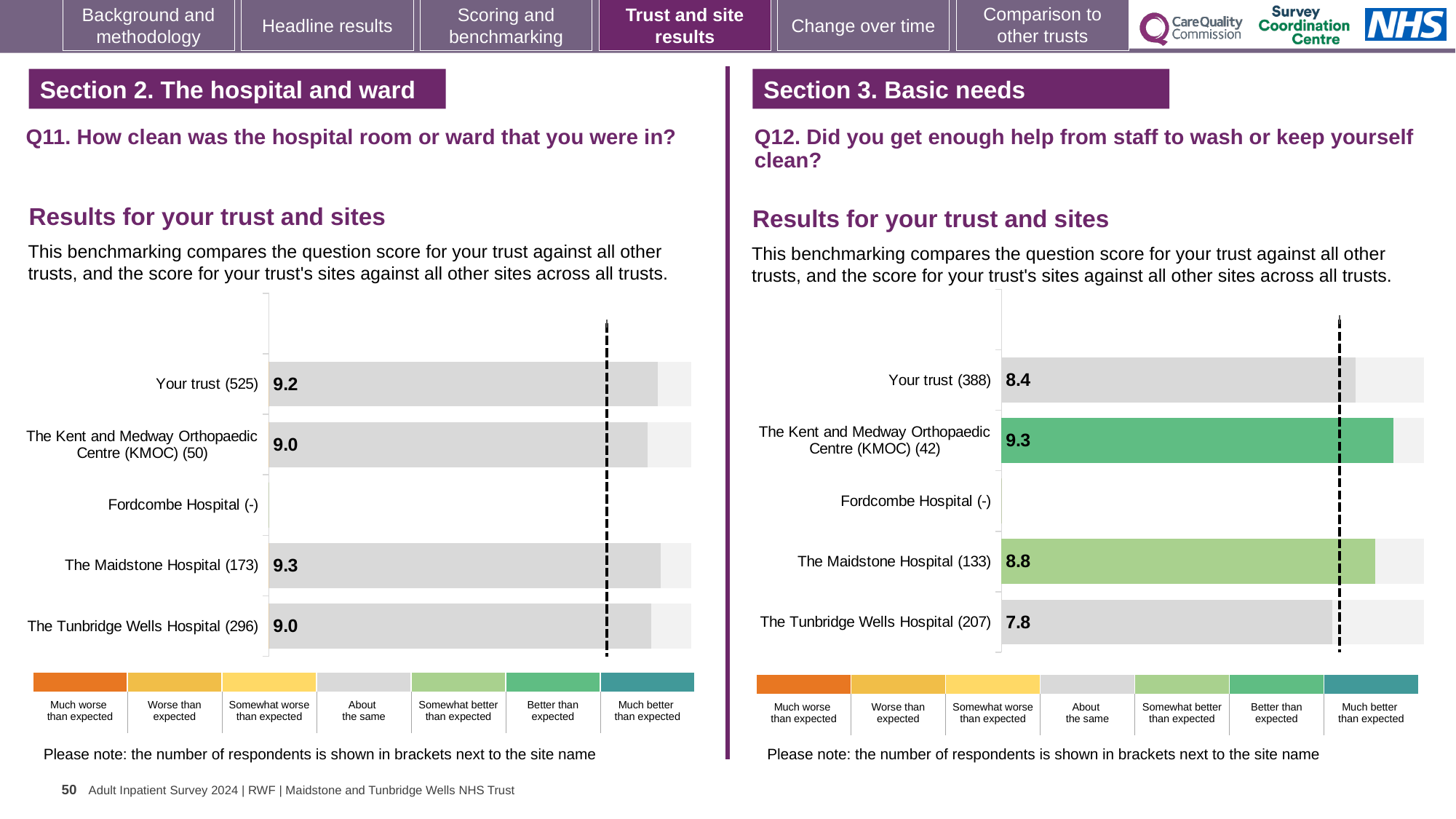
What kind of chart is used for the Q12 results on the right? Bar chart How many site/trust categories are listed on the Q11 chart on the left? 5 In the Q12 chart on the right, what is the score for The Tunbridge Wells Hospital (207)? 7.8 In the Q12 chart on the right, what is the score for The Kent and Medway Orthopaedic Centre (KMOC) (42)? 9.3 In the Q11 chart on the left, what is the score for The Maidstone Hospital (173)? 9.3 In the Q12 chart on the right, which benchmark category does the colour of the KMOC bar correspond to? Better than expected In the Q12 chart on the right, which site has the lowest score? The Tunbridge Wells Hospital (207) In the Q11 chart on the left, what is the score for Your trust (525)? 9.2 In the Q12 chart on the right, what is the difference between the scores for KMOC and The Tunbridge Wells Hospital? 1.5 In the Q12 chart on the right, which is larger: the score for Your trust or the score for The Maidstone Hospital? The Maidstone Hospital In the Q11 chart on the left, which site has the highest score? The Maidstone Hospital (173) In the Q11 chart on the left, what is the difference between the scores for The Maidstone Hospital and Your trust? 0.1